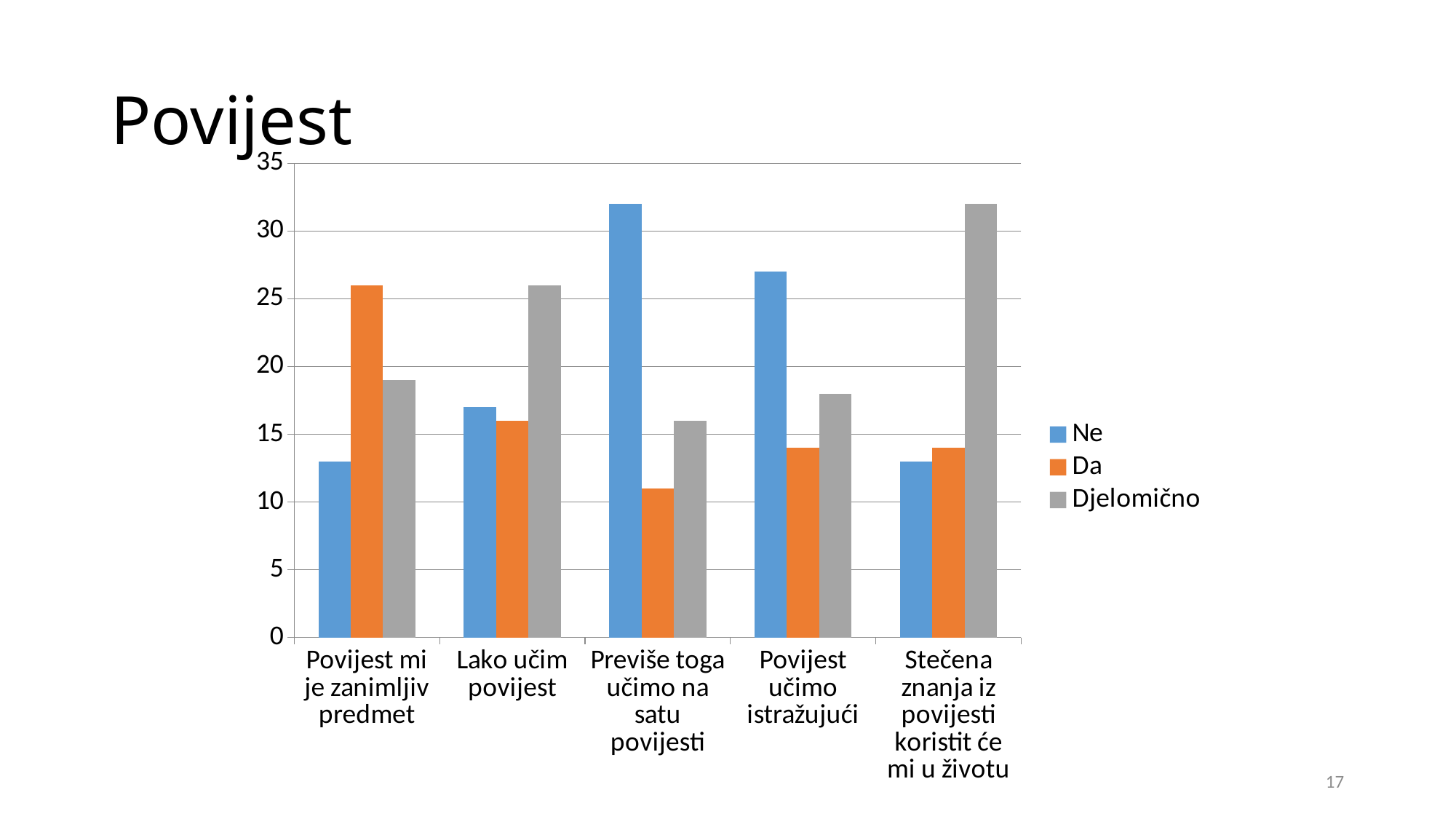
What kind of chart is shown on the slide? bar chart Which category has the highest value for the Djelomično series? Stečena znanja iz povijesti koristit će mi u životu How many categories are shown on the x axis? 5 Is the Djelomično value for 'Lako učim povijest' greater or less than 20? greater Is the Ne value for 'Previše toga učimo na satu povijesti' greater or less than 30? greater Which category has the lowest value for the Da series? Previše toga učimo na satu povijesti For 'Povijest mi je zanimljiv predmet', which is larger: Da or Djelomično? Da Is the Da value for 'Previše toga učimo na satu povijesti' greater or less than 15? less For 'Lako učim povijest', which is larger: Ne or Djelomično? Djelomično How many series does the legend list? 3 What is the title of the slide containing the chart? Povijest Which category has the highest value for the Ne series? Previše toga učimo na satu povijesti